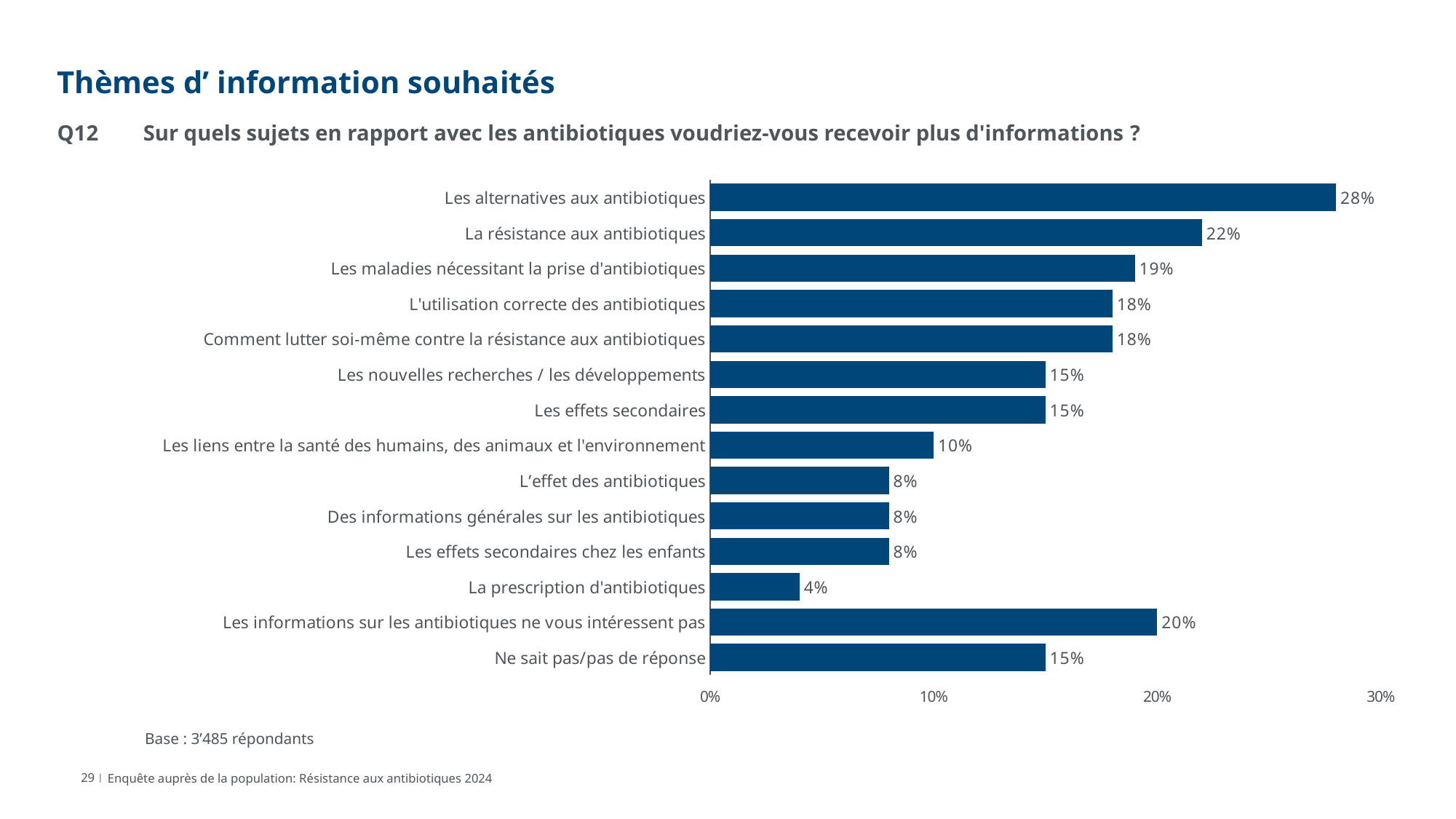
What is the difference between "Les alternatives aux antibiotiques" and "La résistance aux antibiotiques"? 6% Is the value for "La résistance aux antibiotiques" greater or less than 20%? greater What is the value for "Les informations sur les antibiotiques ne vous intéressent pas"? 20% Which category has the highest value? Les alternatives aux antibiotiques What is the value for "Les alternatives aux antibiotiques"? 28% What is the base (number of respondents) stated below the chart? 3'485 répondants What is the value for "Les liens entre la santé des humains, des animaux et l'environnement"? 10% Which category has the lowest value? La prescription d'antibiotiques What kind of chart is shown on the slide? Bar chart What is the difference between "Les maladies nécessitant la prise d'antibiotiques" and "La prescription d'antibiotiques"? 15% How many categories are shown in the chart? 14 Which is larger: "Les nouvelles recherches / les développements" or "L'utilisation correcte des antibiotiques"? L'utilisation correcte des antibiotiques